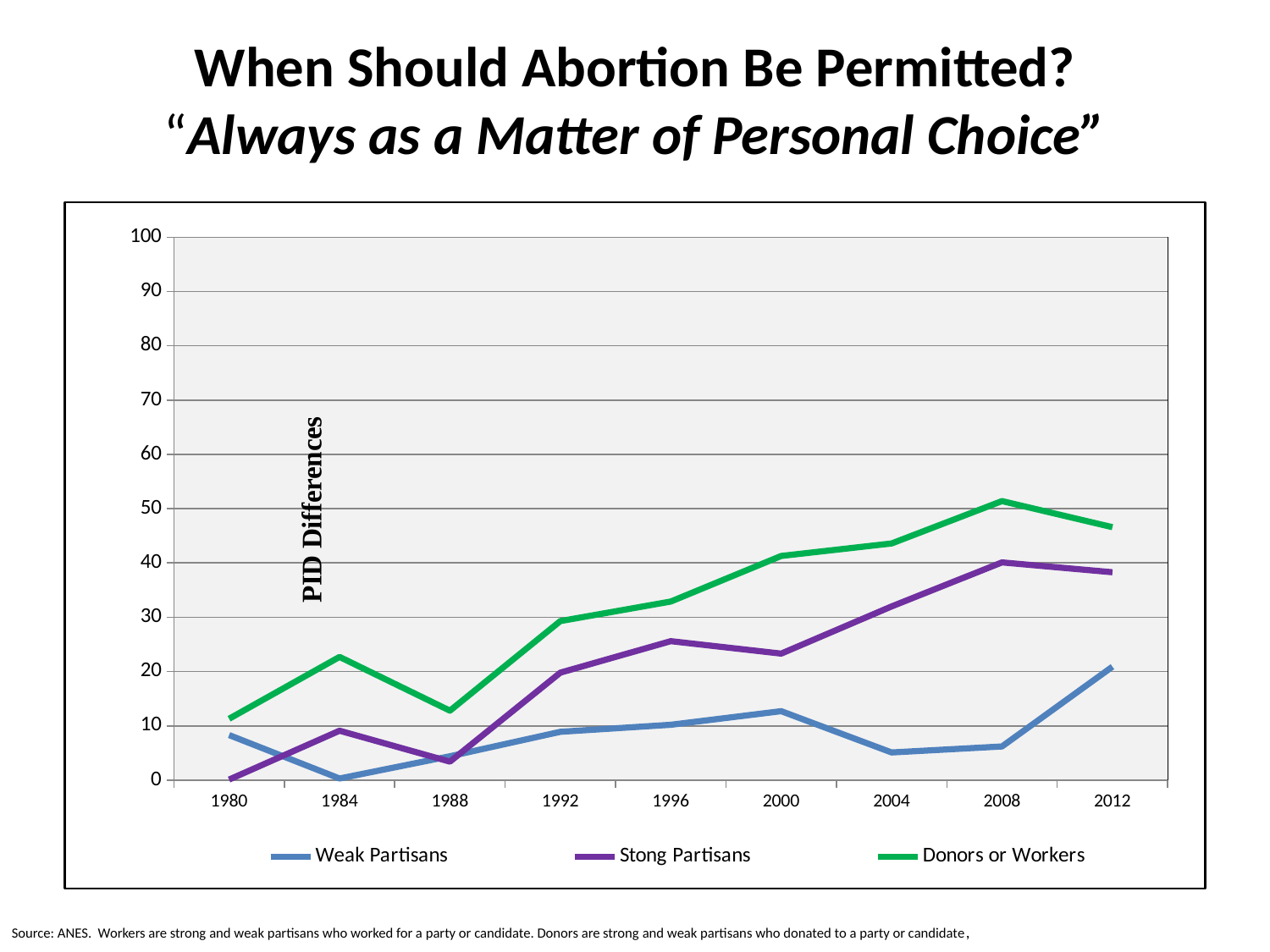
Does the Weak Partisans line rise or fall between 2004 and 2012? Rise How many years are plotted along the x axis? 9 Which series has the highest value in 2012? Donors or Workers How many series does the legend list? 3 In which year is the Weak Partisans line at its lowest? 1984 What is the label on the y axis? PID Differences Is the value for Stong Partisans in 1996 greater or less than 20? greater In 1984, which is larger: the value for Weak Partisans or the value for Stong Partisans? Stong Partisans In which year does the Donors or Workers line reach its highest value? 2008 Is the value for Weak Partisans in 2004 greater or less than 10? less Is the value for Donors or Workers in 2012 greater or less than 40? greater What kind of chart is shown on the slide? Line chart